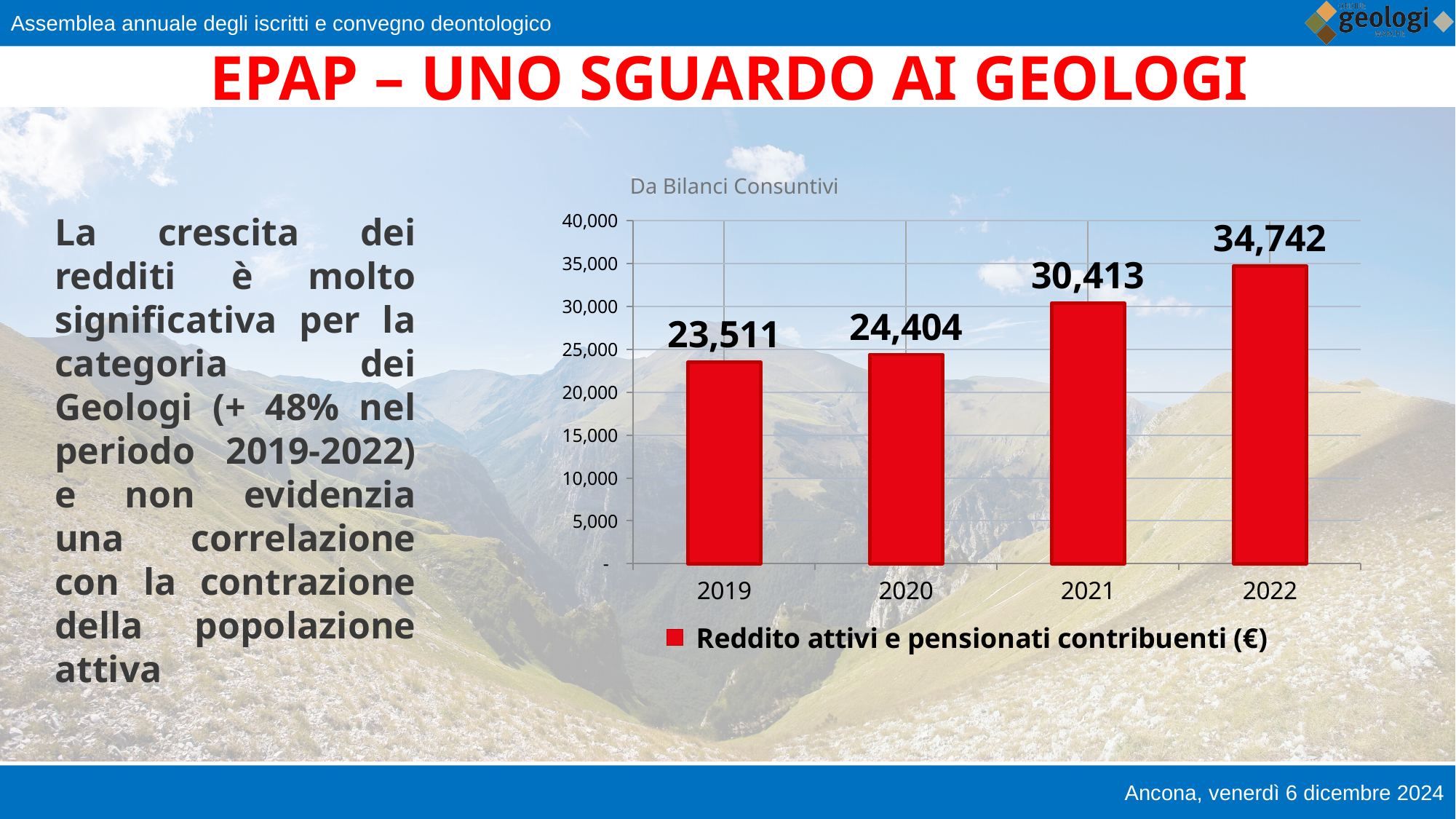
What kind of chart is shown? Bar chart What is the value for 2022? 34,742 Do the values rise or fall from 2019 to 2022? Rise Which is larger, the value for 2020 or the value for 2021? 2021 What is the difference between the values for 2022 and 2019? 11,231 How many years are shown on the x axis? 4 What is the value for 2021? 30,413 Which year has the highest value? 2022 What is the value for 2020? 24,404 What is the difference between the values for 2021 and 2020? 6,009 What is the value for 2019? 23,511 Which year has the lowest value? 2019